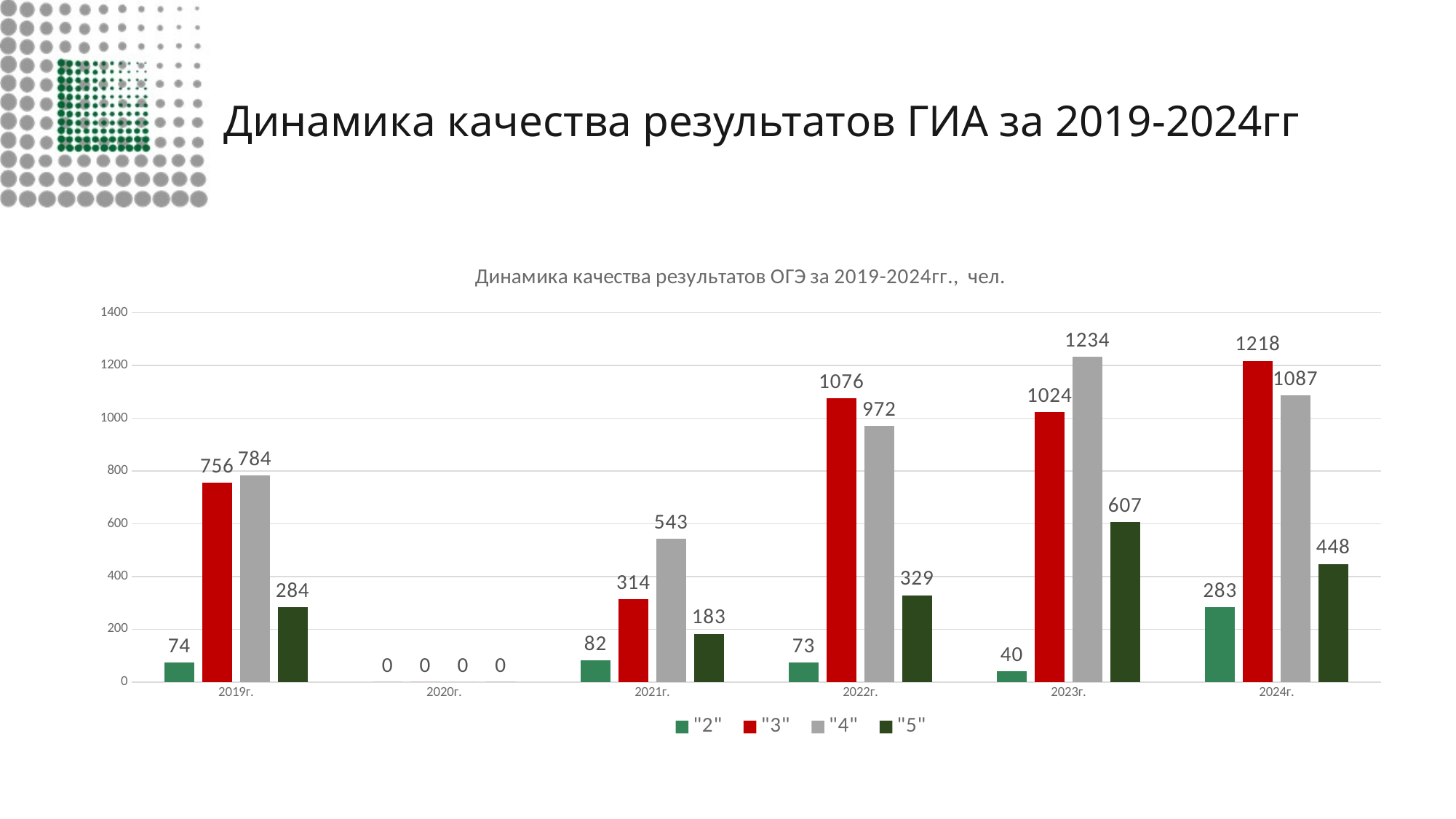
What is the total of the four series values for 2022г.? 2450 What is the chart's title? Динамика качества результатов ОГЭ за 2019-2024гг., чел. What is the difference between the values for series "4" and series "3" in 2019г.? 28 How many year categories are shown on the x axis? 6 Which is larger in 2024г.: the value for series "3" or series "4"? "3" How many series does the legend list? 4 What is the value for series "2" in 2024г.? 283 Excluding 2020г., in which year is the value for series "5" the lowest? 2021г. What kind of chart is shown on the slide? Bar chart In which year is the value for series "3" the highest? 2024г. What is the value for series "5" in 2021г.? 183 What is the value for series "4" in 2023г.? 1234